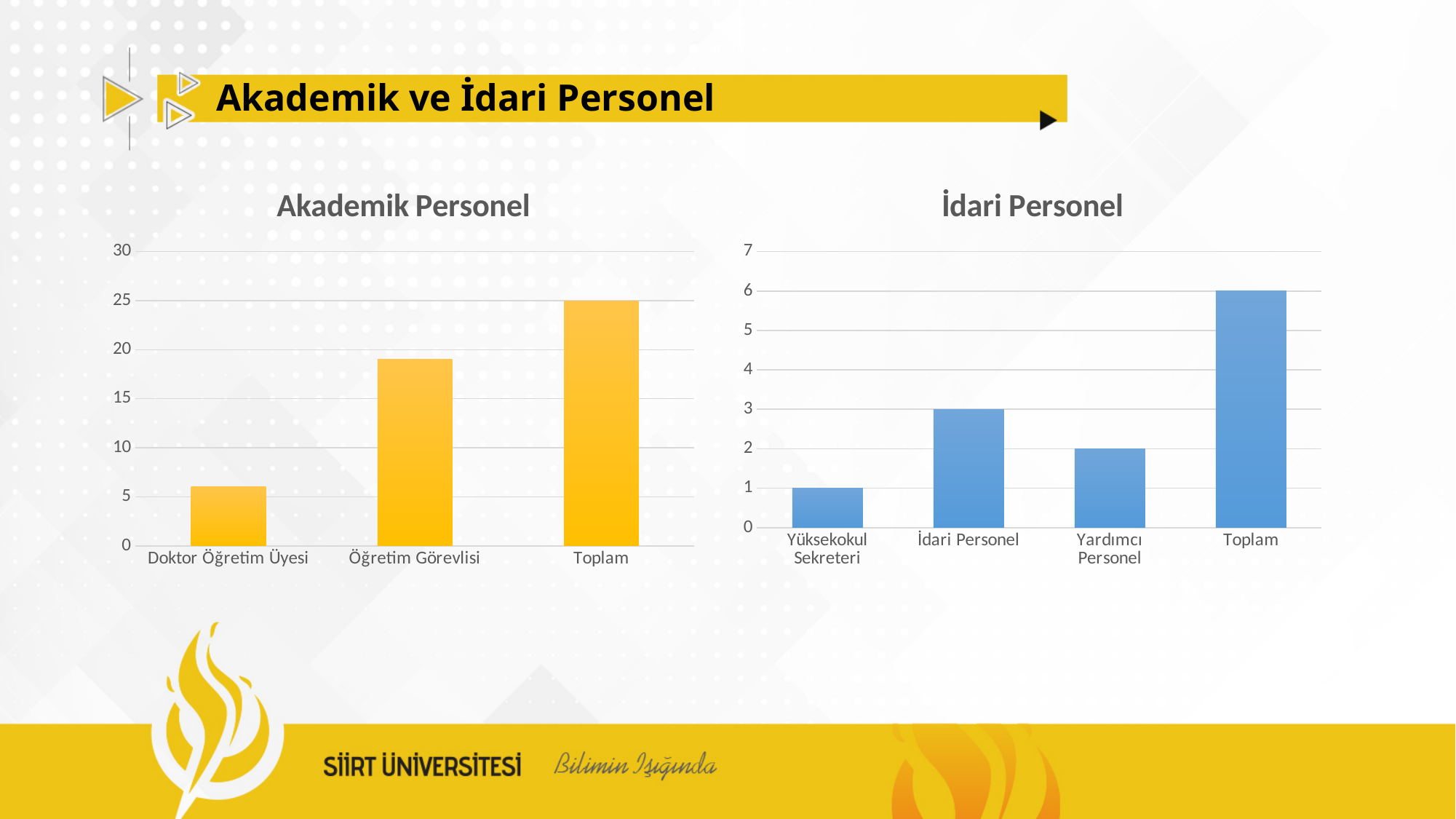
In the Akademik Personel chart, what is the value for Toplam? 25 In the Akademik Personel chart, which category has the lowest value? Doktor Öğretim Üyesi How many categories are shown in the İdari Personel chart? 4 In the İdari Personel chart, what is the value for Yardımcı Personel? 2 What type of chart is the İdari Personel chart? bar chart In the Akademik Personel chart, is the value for Öğretim Görevlisi greater or less than 20? less In the İdari Personel chart, what is the difference between the values for İdari Personel and Yüksekokul Sekreteri? 2 In the Akademik Personel chart, is the value for Doktor Öğretim Üyesi greater or less than 5? greater In the İdari Personel chart, which is larger, İdari Personel or Yardımcı Personel? İdari Personel In the İdari Personel chart, what is the value for Toplam? 6 In the İdari Personel chart, which category has the lowest value? Yüksekokul Sekreteri How many categories are shown in the Akademik Personel chart? 3